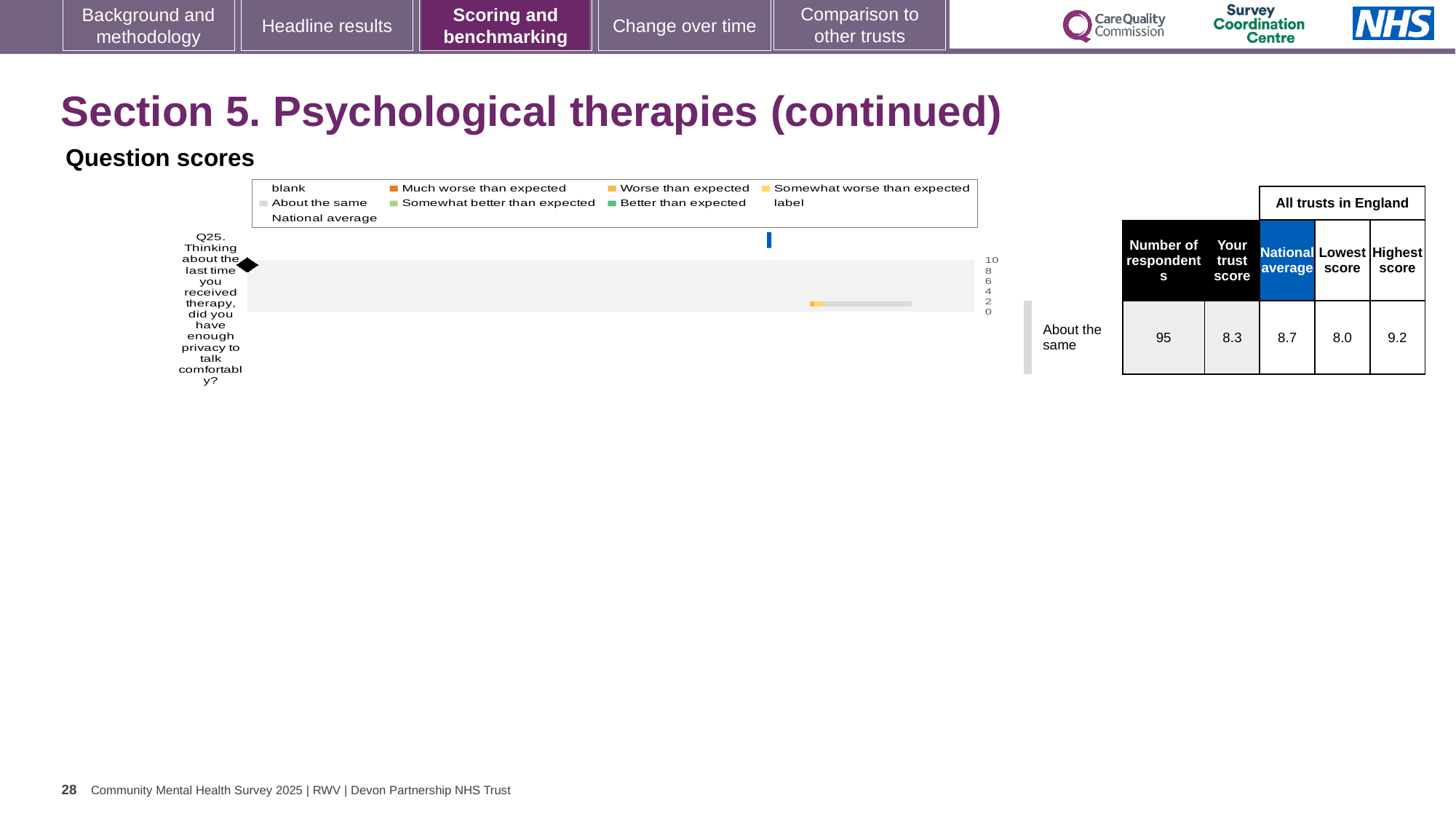
According to the table next to the chart, what is the national average score for Q25? 8.7 What is the highest value shown on the axis of the Question scores chart? 10 According to the table next to the chart, how many respondents answered Q25? 95 According to the table next to the chart, what is the trust's score for Q25? 8.3 What is the difference between the national average (8.7) and the trust's score (8.3) for Q25? 0.4 According to the table next to the chart, what is the lowest score among all trusts in England for Q25? 8.0 What kind of chart is shown under 'Question scores'? bar chart According to the table next to the chart, what is the highest score among all trusts in England for Q25? 9.2 How many questions (categories) are plotted in the Question scores chart? 1 Which question is plotted in the Question scores chart? Q25. Thinking about the last time you received therapy, did you have enough privacy to talk comfortably? Which is larger for Q25, the trust's score or the national average? national average What benchmark category is the trust's Q25 score placed in? About the same